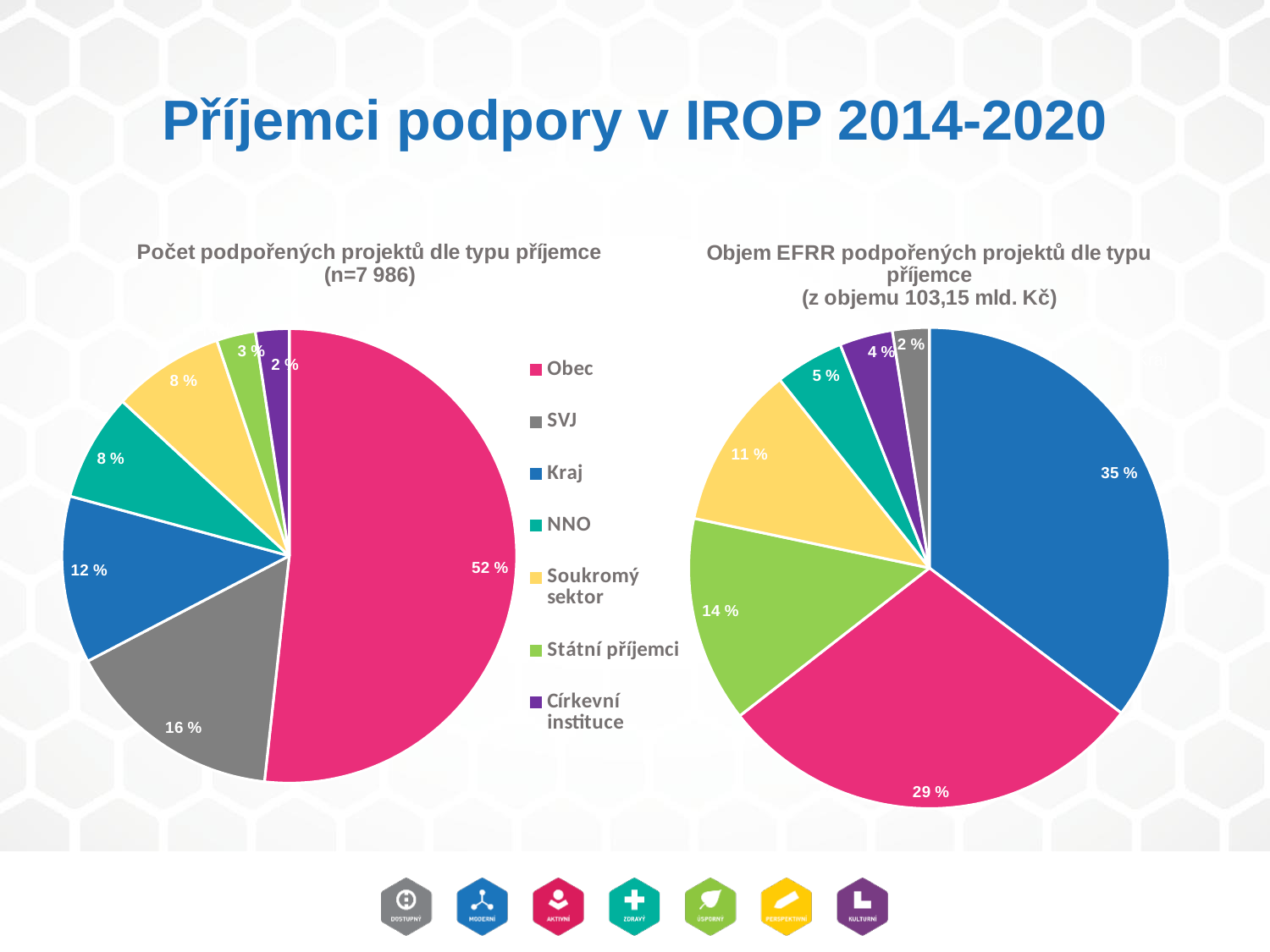
In the right chart (Objem EFRR podpořených projektů dle typu příjemce), what share of the EFRR volume goes to Kraj? 35 % In the right chart (Objem EFRR podpořených projektů dle typu příjemce), which recipient type has the smallest slice? SVJ What total volume is stated in the title of the right chart? 103,15 mld. Kč In the left chart (Počet podpořených projektů dle typu příjemce), what share of projects goes to SVJ? 16 % In the right chart (Objem EFRR podpořených projektů dle typu příjemce), what is the difference in percentage points between Kraj and Obec? 6 percentage points How many recipient types does the legend list? 7 In the left chart (Počet podpořených projektů dle typu příjemce), which is larger: the share for Kraj or the share for NNO? Kraj What type of chart is used on this slide? Pie chart In the right chart (Objem EFRR podpořených projektů dle typu příjemce), what share of the EFRR volume goes to Státní příjemci? 14 % In the left chart (Počet podpořených projektů dle typu příjemce), which recipient type has the largest slice? Obec In the left chart (Počet podpořených projektů dle typu příjemce), what share of projects goes to Obec? 52 % In the right chart (Objem EFRR podpořených projektů dle typu příjemce), what is the combined share of Kraj and Obec? 64 %